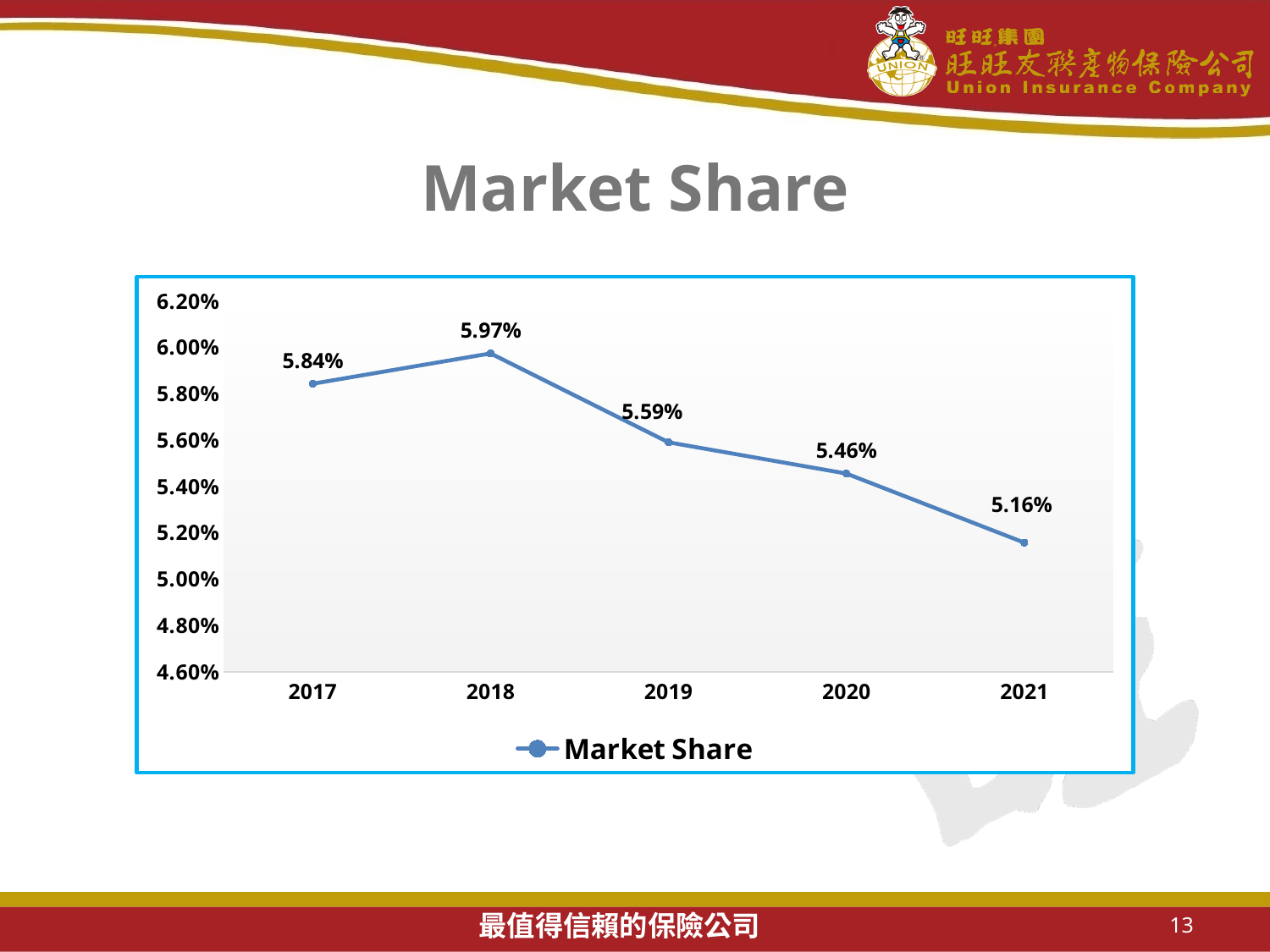
Does the market share rise or fall from 2018 to 2021? fall Which year has the highest market share? 2018 How many years are plotted on the chart? 5 What is the market share for 2021? 5.16% What is the difference in market share between 2017 and 2018? 0.13% What kind of chart is shown on the slide? line chart What is the difference in market share between 2018 and 2021? 0.81% Which year has a larger market share, 2017 or 2020? 2017 Is the market share for 2020 greater or less than 5.60%? less What is the market share for 2019? 5.59% Which year has the lowest market share? 2021 What is the market share for 2018? 5.97%